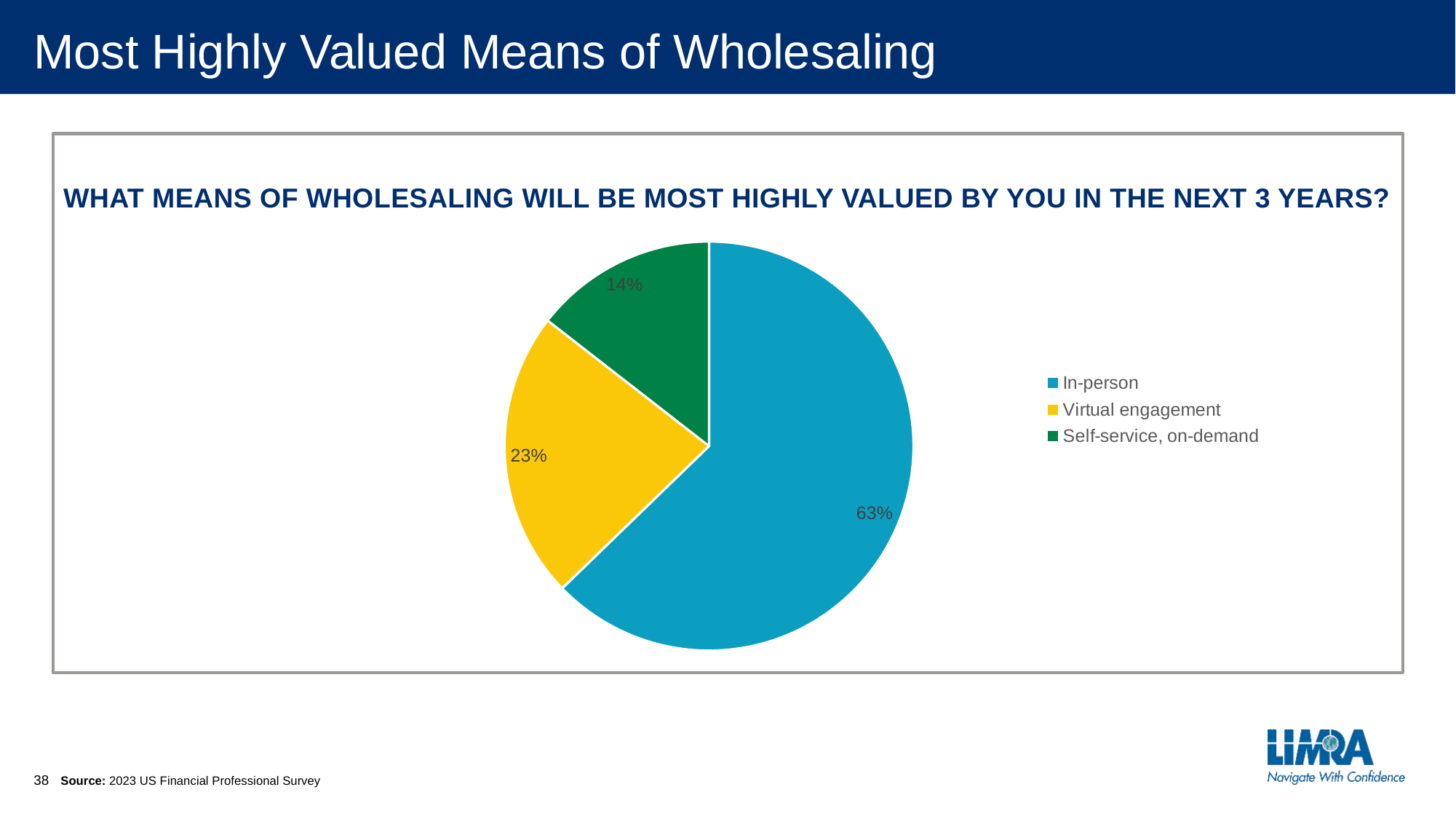
What is the value shown for Self-service, on-demand? 14% How many slices does the pie chart have? 3 What is the value shown for Virtual engagement? 23% Which is larger, the share for Virtual engagement or the share for Self-service, on-demand? Virtual engagement What is the difference in percentage points between In-person and Virtual engagement? 40 How many entries does the legend list? 3 Which means of wholesaling has the smallest share of the pie? Self-service, on-demand What kind of chart is shown on the slide? Pie chart What is the difference in percentage points between Virtual engagement and Self-service, on-demand? 9 Which means of wholesaling has the largest share of the pie? In-person What colour is the slice for Virtual engagement? Yellow What share of the pie does In-person represent? 63%